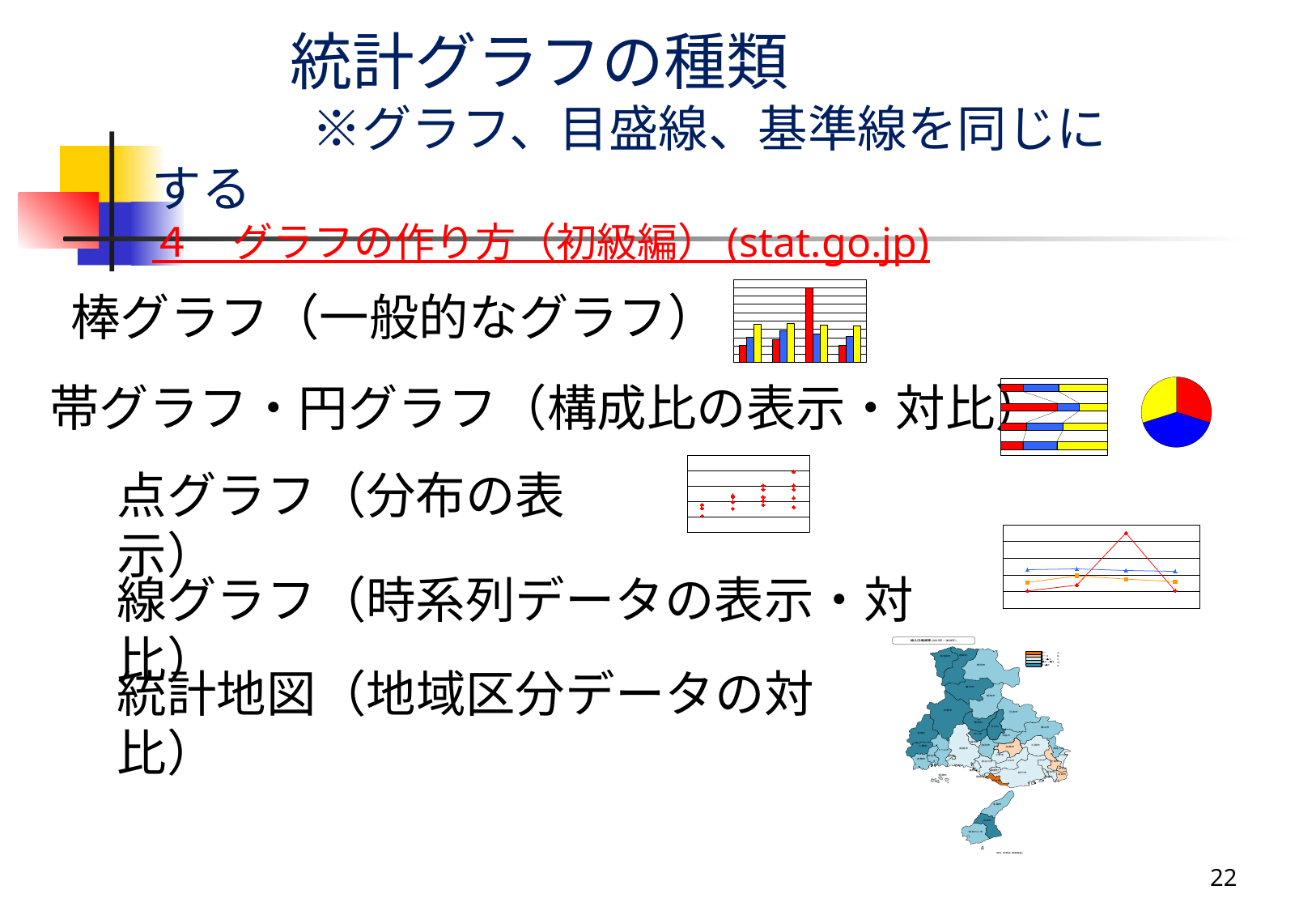
How many lines are plotted in the line chart on the slide? 3 What three colours are used for the slices of the pie chart? yellow, red and blue How many horizontal stacked bars does the band chart (帯グラフ) next to the 帯グラフ・円グラフ line contain? 4 What kind of chart is the circular chart at the right of the 帯グラフ・円グラフ line? pie chart How many slices does the pie chart on the slide have? 3 In the bar chart next to 棒グラフ, which colour of bar reaches the highest value? red In the line chart on the slide, which coloured line has the highest peak? red What kind of chart is shown next to the text 棒グラフ（一般的なグラフ）? bar chart What kind of chart is shown next to the text 点グラフ（分布の表示）? dot plot (scatter chart) What three colours are used for the bars in the bar chart next to 棒グラフ? red, blue and yellow